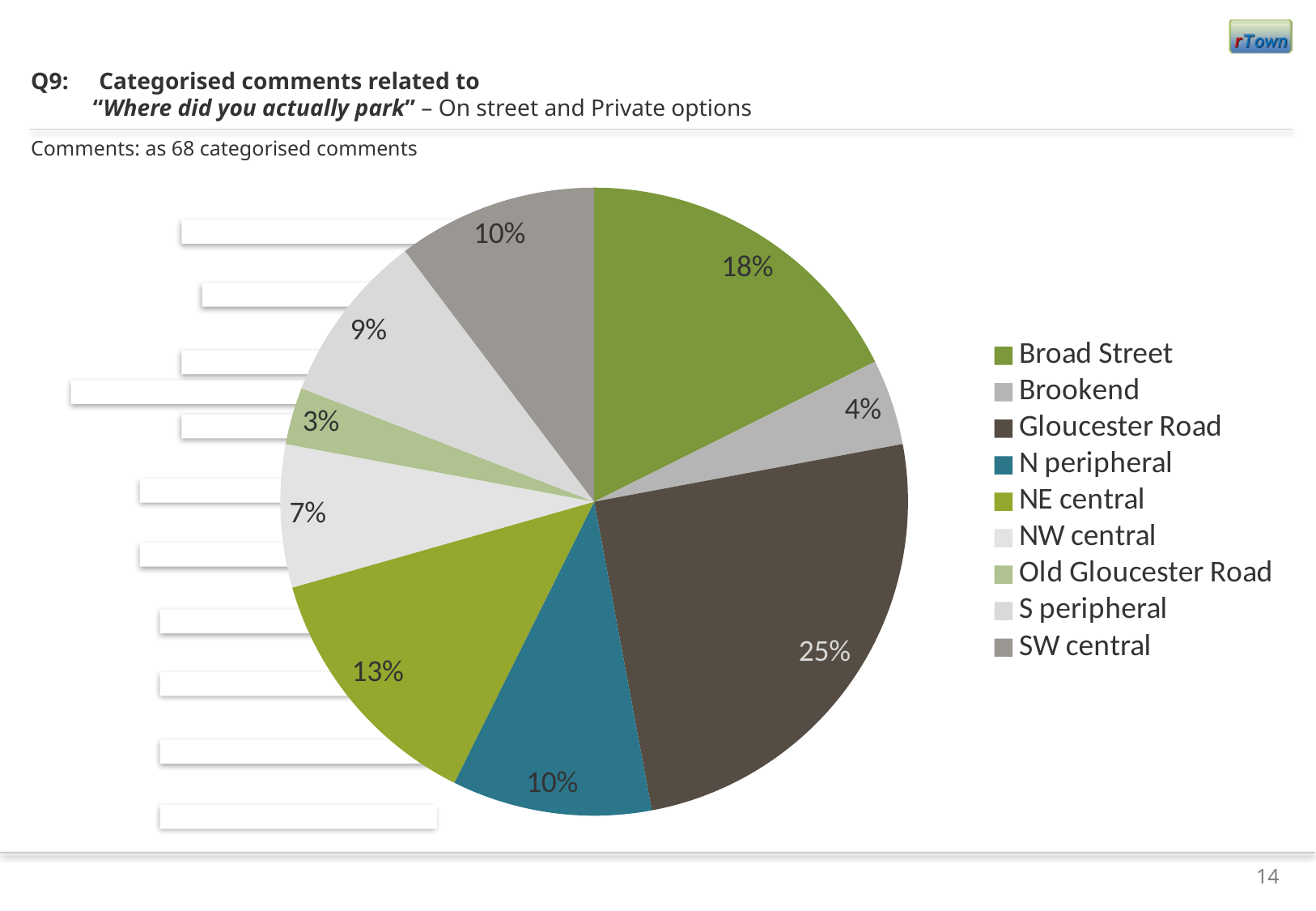
How many categories does the legend list? 9 Which is larger, the share for NE central or the share for S peripheral? NE central Which category has the smallest slice of the pie? Old Gloucester Road What is the value shown for NE central? 13% What share of the pie does Gloucester Road have? 25% What is the value shown for Old Gloucester Road? 3% Which category has the largest slice of the pie? Gloucester Road What kind of chart is shown on the slide? Pie chart How many categorised comments does the slide say the chart is based on? 68 What share of the pie does Broad Street have? 18% What is the difference between the shares for Gloucester Road and Broad Street? 7% What is the value shown for Brookend? 4%